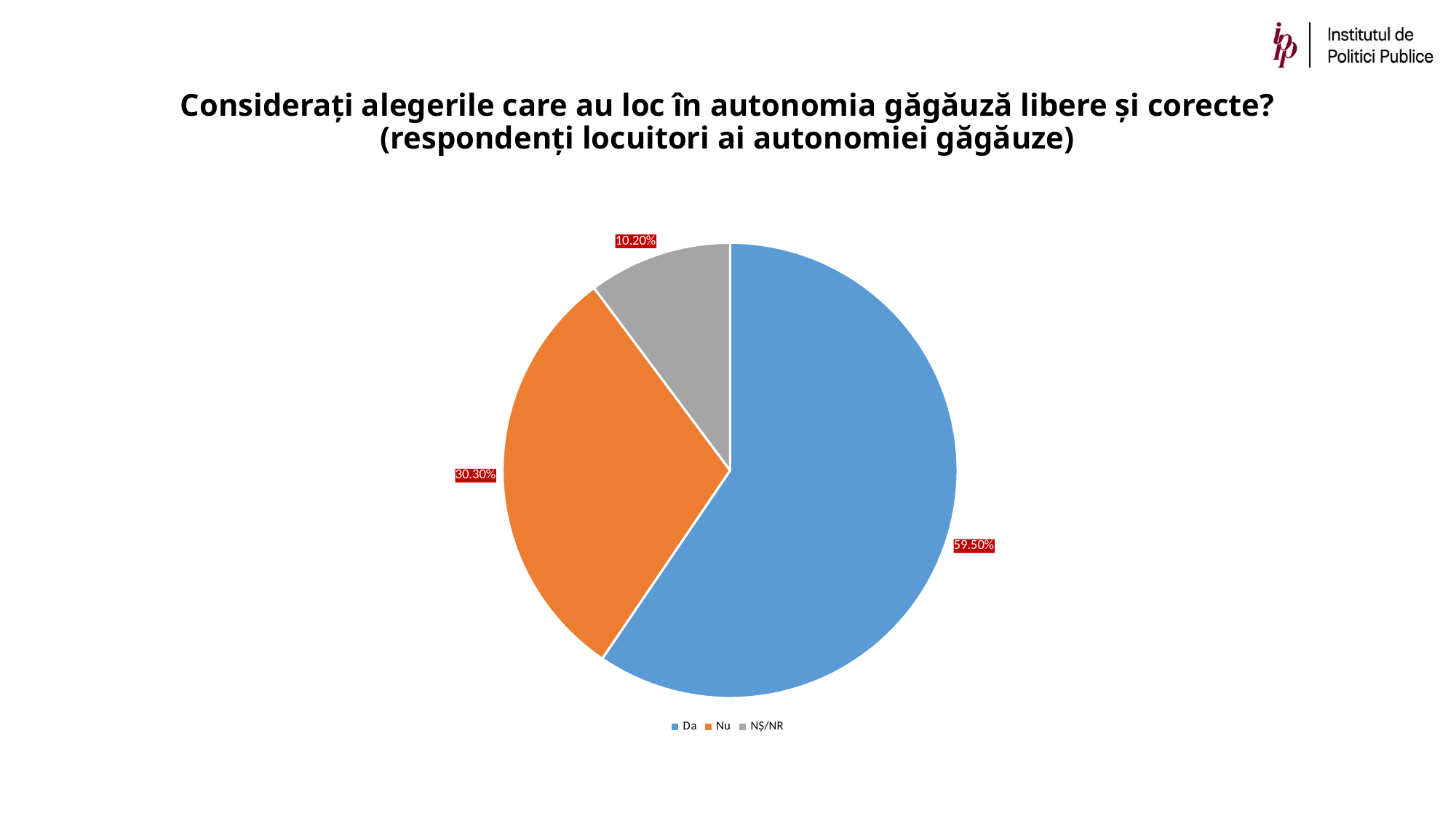
Which slice is larger, "Nu" or "NȘ/NR"? Nu What is the difference in percentage points between the "Nu" and "NȘ/NR" slices? 20.10 What share of respondents answered "NȘ/NR"? 10.20% Which answer has the smallest slice of the pie? NȘ/NR How many slices does the pie chart have? 3 What colour is the "Nu" slice? orange What kind of chart is shown on the slide? pie chart What share of respondents answered "Nu"? 30.30% Which answer has the largest slice of the pie? Da What share of respondents answered "Da"? 59.50% How many entries does the legend list? 3 What is the difference in percentage points between the "Da" and "Nu" slices? 29.20